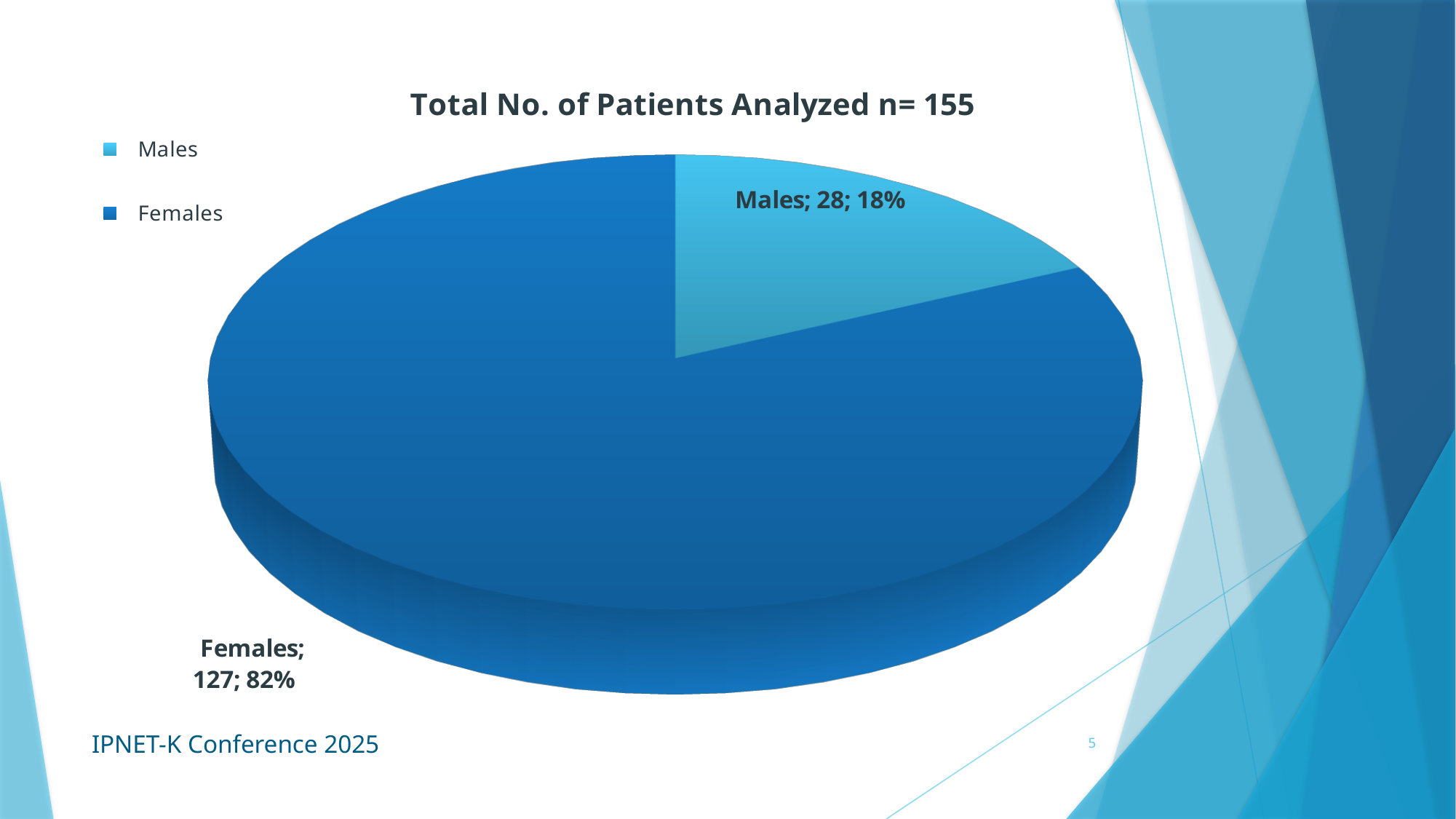
How many patients are Females according to the chart? 127 How many patients are Males according to the chart? 28 What share of the pie do Males represent? 18% How many categories does the pie chart have? 2 What is the title of the chart? Total No. of Patients Analyzed n= 155 What share of the pie do Females represent? 82% How many entries does the legend list? 2 What kind of chart is shown on the slide? pie chart What is the difference between the number of Females and the number of Males? 99 Which category has the largest slice of the pie? Females Which is larger, the number of Males or the number of Females? Females Which category has the smallest slice of the pie? Males